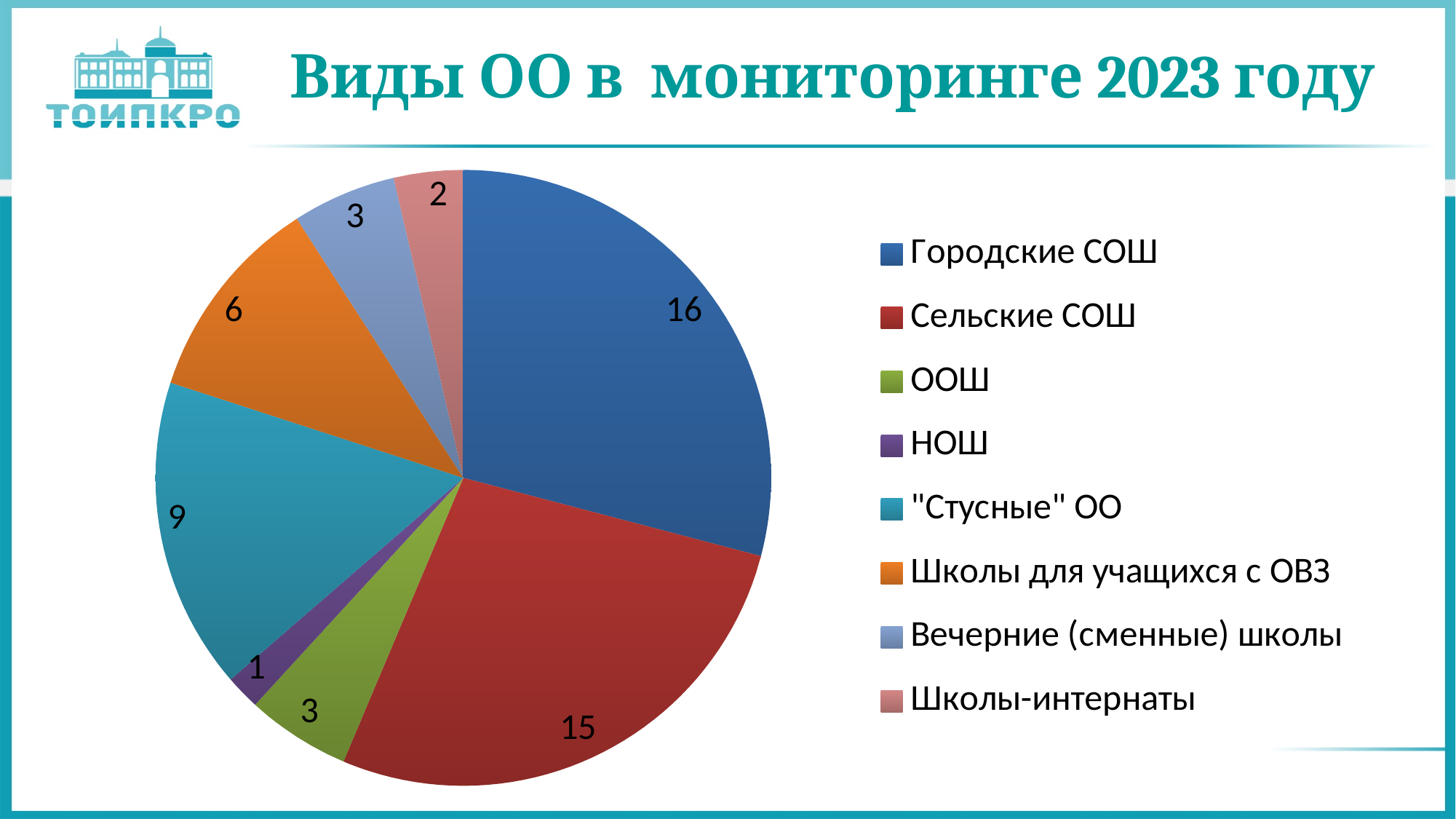
What is the value for Школы для учащихся с ОВЗ? 6 What kind of chart is shown on the slide? pie chart Which category has the largest slice of the pie? Городские СОШ What is the title of the slide? Виды ОО в мониторинге 2023 году What is the value for Сельские СОШ? 15 What is the difference between the values for Городские СОШ and "Стусные" ОО? 7 Which is larger, the value for Школы для учащихся с ОВЗ or the value for Вечерние (сменные) школы? Школы для учащихся с ОВЗ What is the value for "Стусные" ОО? 9 Which category has the smallest slice of the pie? НОШ How many categories does the legend list? 8 What is the value for Городские СОШ? 16 What is the value for Школы-интернаты? 2